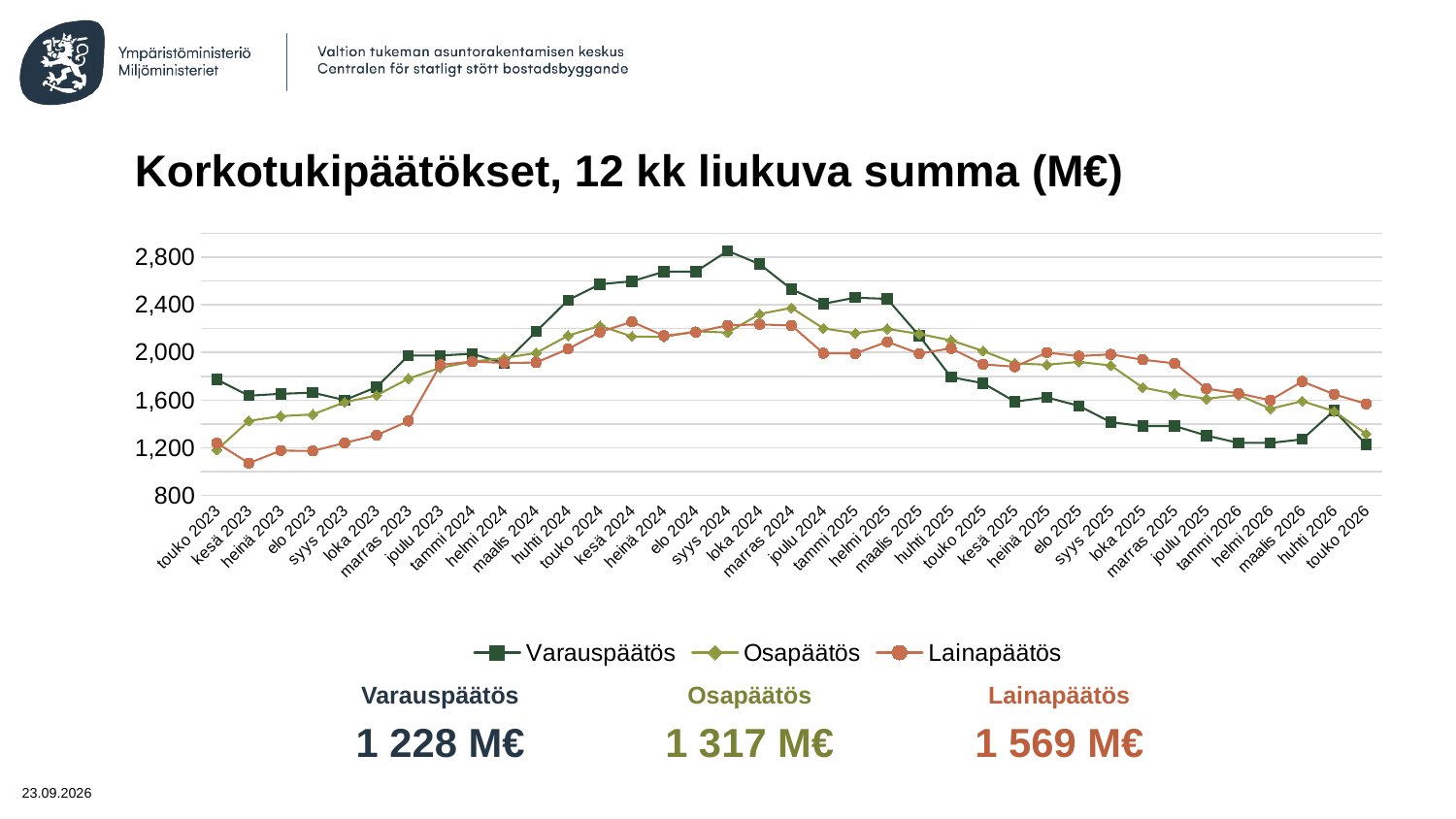
Is the value for Lainapäätös in kesä 2023 greater or less than 1,200? less Is the value for Varauspäätös in syys 2024 greater or less than 2,400? greater Which series has the lowest value for touko 2026? Varauspäätös Does the Varauspäätös line rise or fall from syys 2024 to touko 2026? fall What is the value of Varauspäätös for touko 2026? 1 228 M€ What kind of chart is shown on the slide? line chart How many months are shown on the x axis? 37 How many series does the legend list? 3 What is the difference between Lainapäätös and Varauspäätös for touko 2026? 341 M€ What is the value of Lainapäätös for touko 2026? 1 569 M€ Which series has the highest value for touko 2026? Lainapäätös What is the value of Osapäätös for touko 2026? 1 317 M€